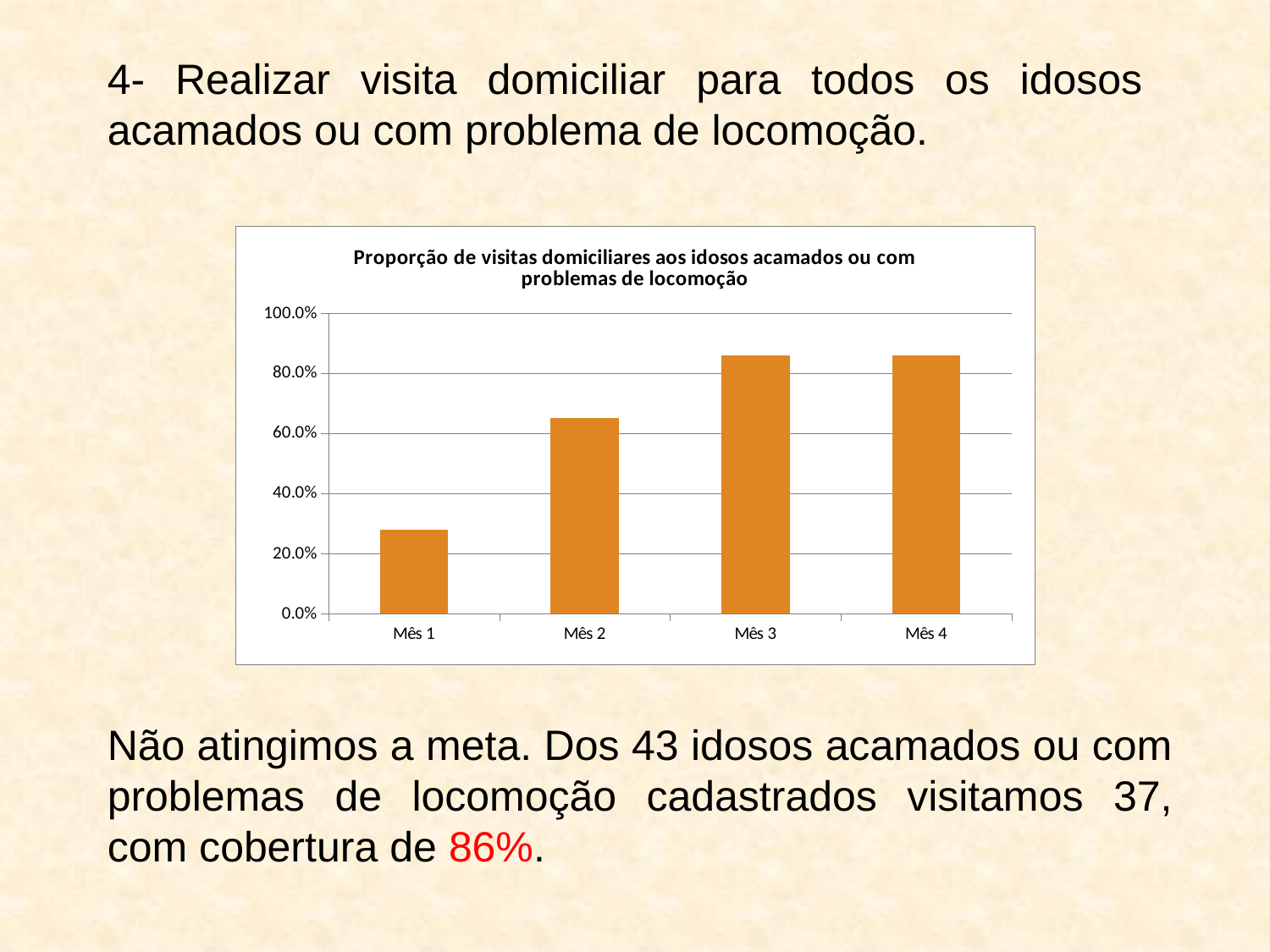
Do the values generally rise or fall from Mês 1 to Mês 4? rise What kind of chart is shown on the slide? bar chart What is the highest value shown on the chart's y axis? 100.0% Is the value for Mês 4 greater or less than 100.0%? less What is the title of the chart? Proporção de visitas domiciliares aos idosos acamados ou com problemas de locomoção Which is larger, the value for Mês 2 or the value for Mês 3? Mês 3 Which is larger, the value for Mês 1 or the value for Mês 2? Mês 2 Is the value for Mês 3 greater or less than 80.0%? greater Which month has the lowest proportion of home visits in the chart? Mês 1 How many categories (months) are shown on the x axis of the chart? 4 Is the value for Mês 2 greater or less than 60.0%? greater